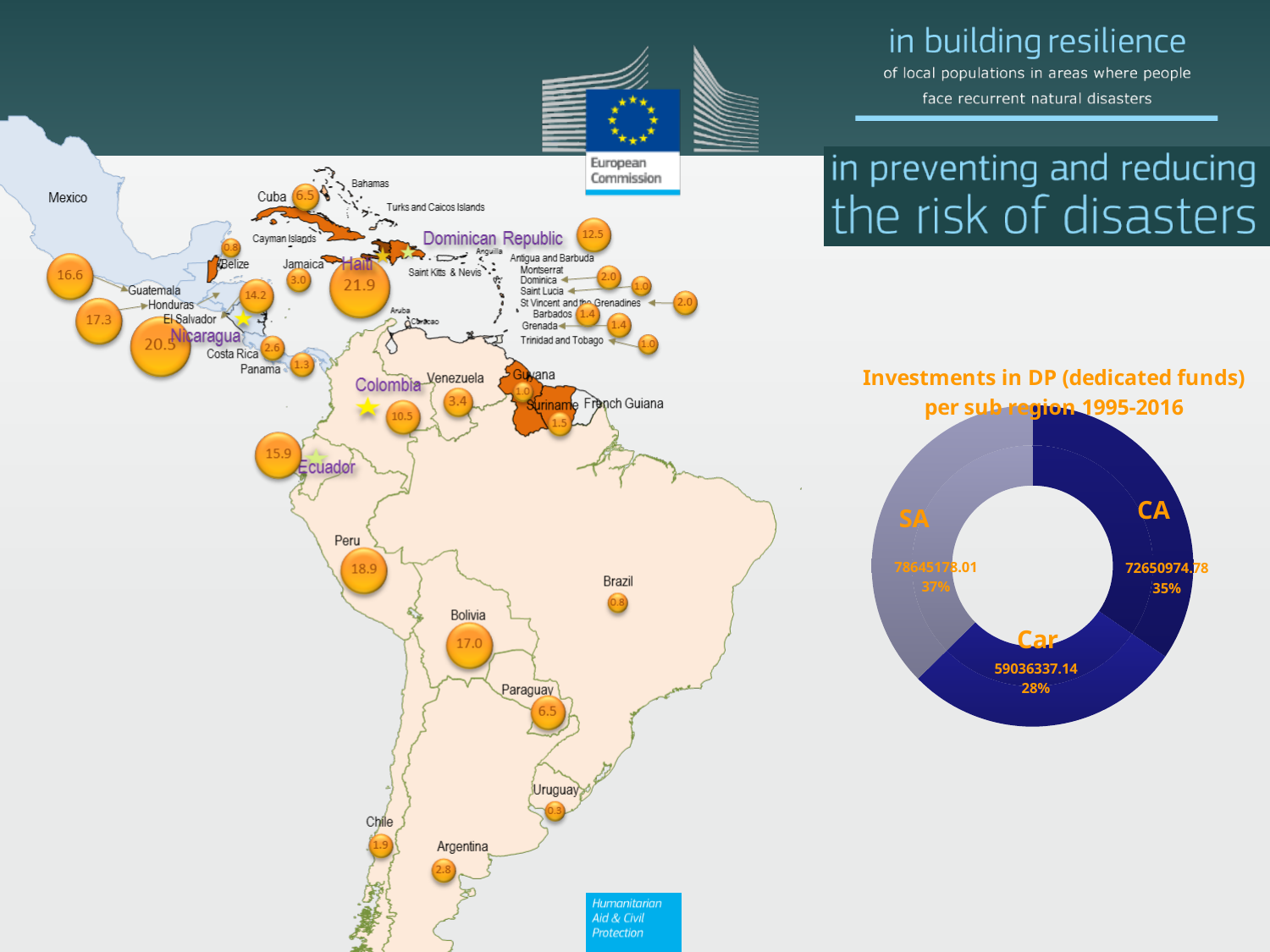
In the doughnut chart, which sub region has the smallest share of investments? Car How many sub regions are shown in the doughnut chart? 3 In the doughnut chart, what is the difference in percentage points between the SA share and the Car share? 9 percentage points In the doughnut chart, what share of the total do the Car investments represent? 28% In the doughnut chart, what is the investment value shown for Car? 59036337.14 In the doughnut chart, what is the investment value shown for CA? 72650974.78 In the doughnut chart 'Investments in DP (dedicated funds) per sub region 1995-2016', what percentage share does SA have? 37% In the doughnut chart, which sub region has the largest share of investments? SA On the map, what value is shown in the bubble for Haiti? 21.9 In the doughnut chart, which sub region has a larger share, CA or Car? CA What kind of chart is used to show investments in DP per sub region? Doughnut chart What is the title of the chart on the right side of the slide? Investments in DP (dedicated funds) per sub region 1995-2016